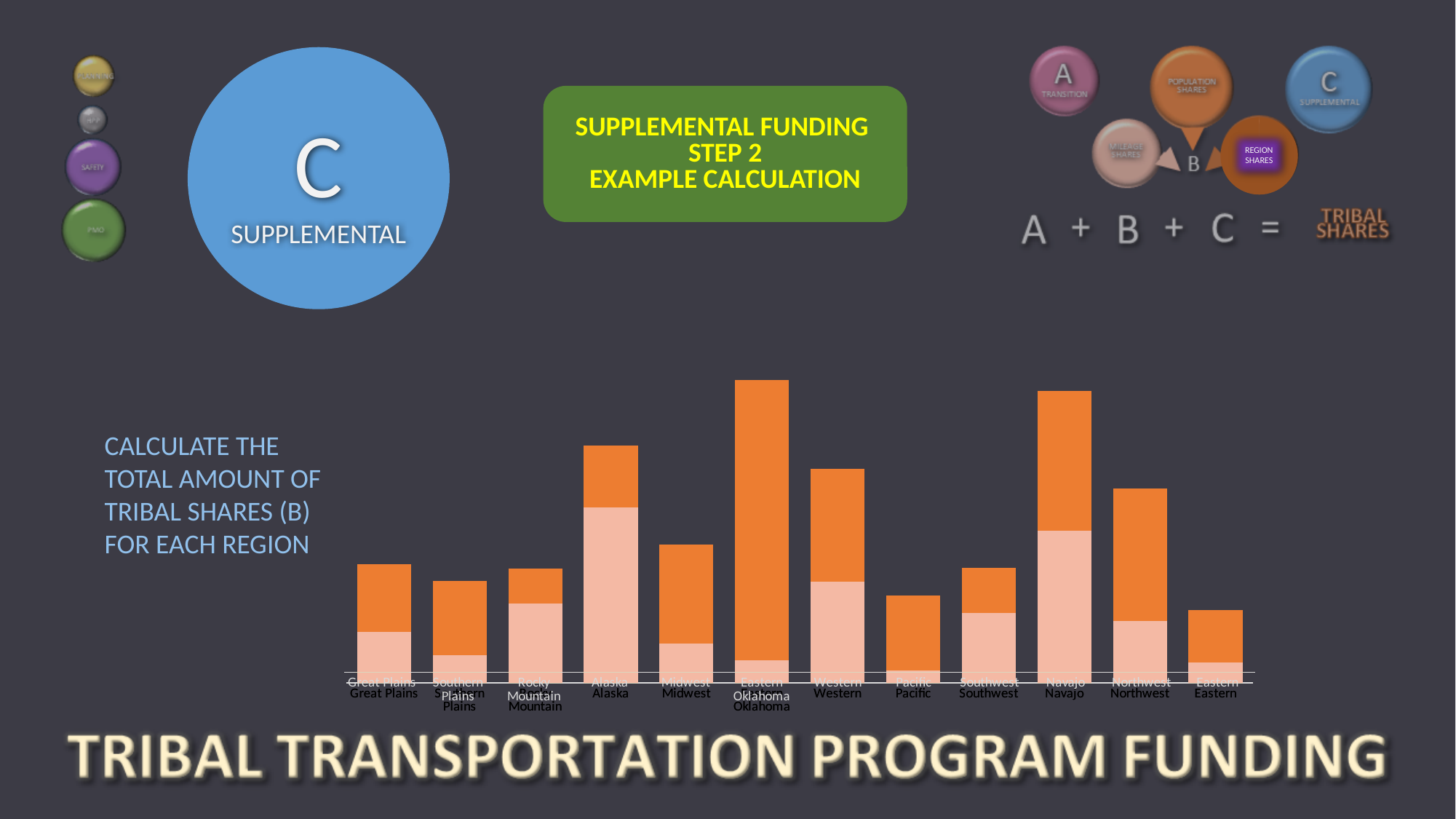
Which bar is taller, Eastern Oklahoma or Midwest? Eastern Oklahoma What kind of chart is shown on the slide? Stacked bar chart What is the first region listed on the x axis of the chart? Great Plains Which region has the tallest bar in the chart? Eastern Oklahoma Which bar is taller, Rocky Mountain or Pacific? Rocky Mountain Which bar is taller, Navajo or Northwest? Navajo How many regions (categories) are plotted on the bar chart? 12 Which region has the largest lighter (bottom) segment in its bar? Alaska How many stacked segments does each bar in the chart have? 2